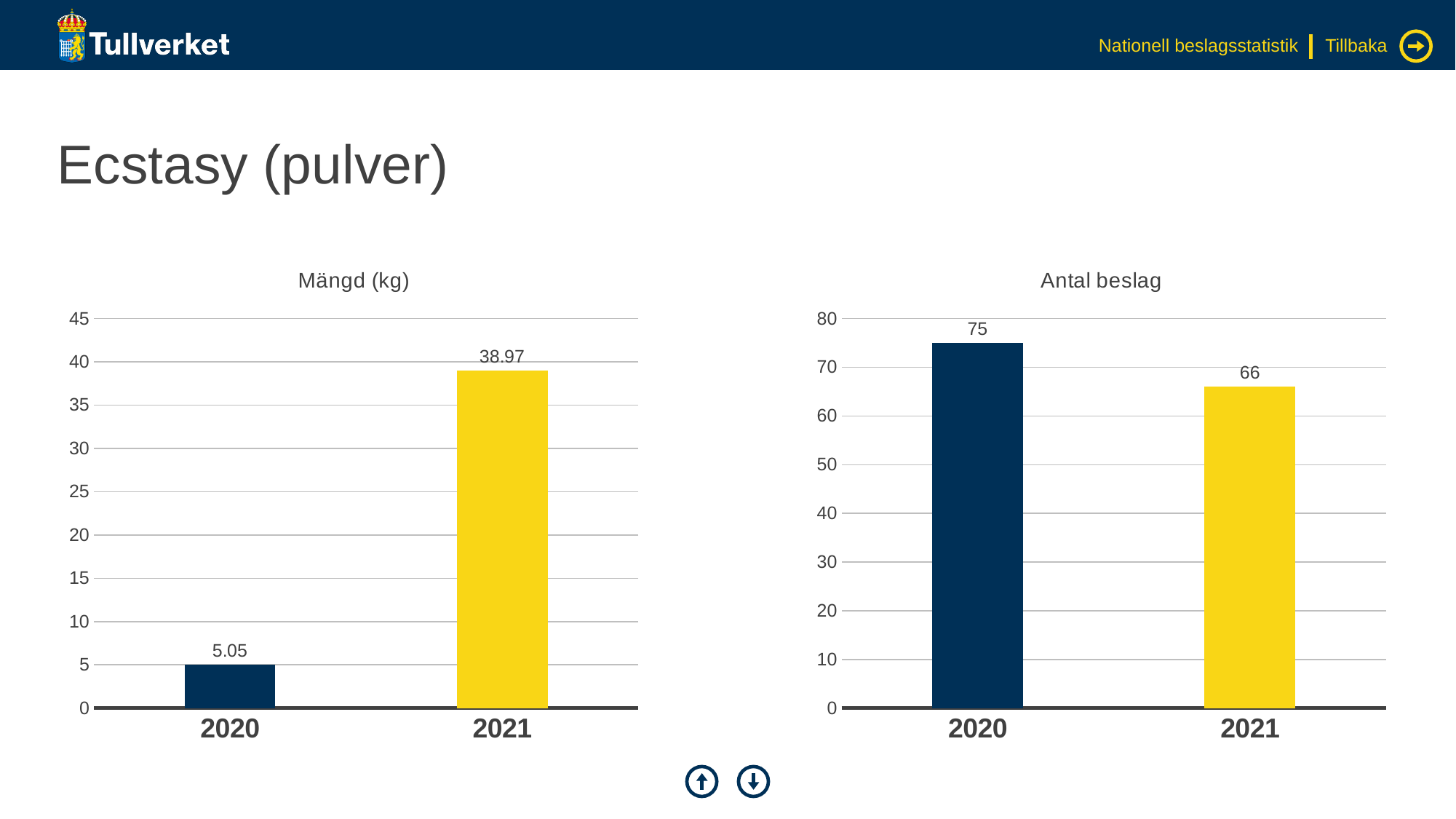
In the 'Antal beslag' chart, what is the difference between the values for 2020 and 2021? 9 In the 'Antal beslag' chart, do the values rise or fall from 2020 to 2021? fall What kind of chart is the 'Mängd (kg)' chart? bar chart In the 'Mängd (kg)' chart, which year has the lowest value? 2020 In the 'Mängd (kg)' chart, what is the value for 2020? 5.05 In the 'Antal beslag' chart, what is the value for 2021? 66 In the 'Mängd (kg)' chart, what is the value for 2021? 38.97 How many categories does the 'Antal beslag' chart show? 2 In the 'Mängd (kg)' chart, what is the difference between the values for 2021 and 2020? 33.92 In the 'Antal beslag' chart, what is the value for 2020? 75 In the 'Mängd (kg)' chart, is the value for 2021 greater or less than 35? greater In the 'Antal beslag' chart, which year has the highest value? 2020